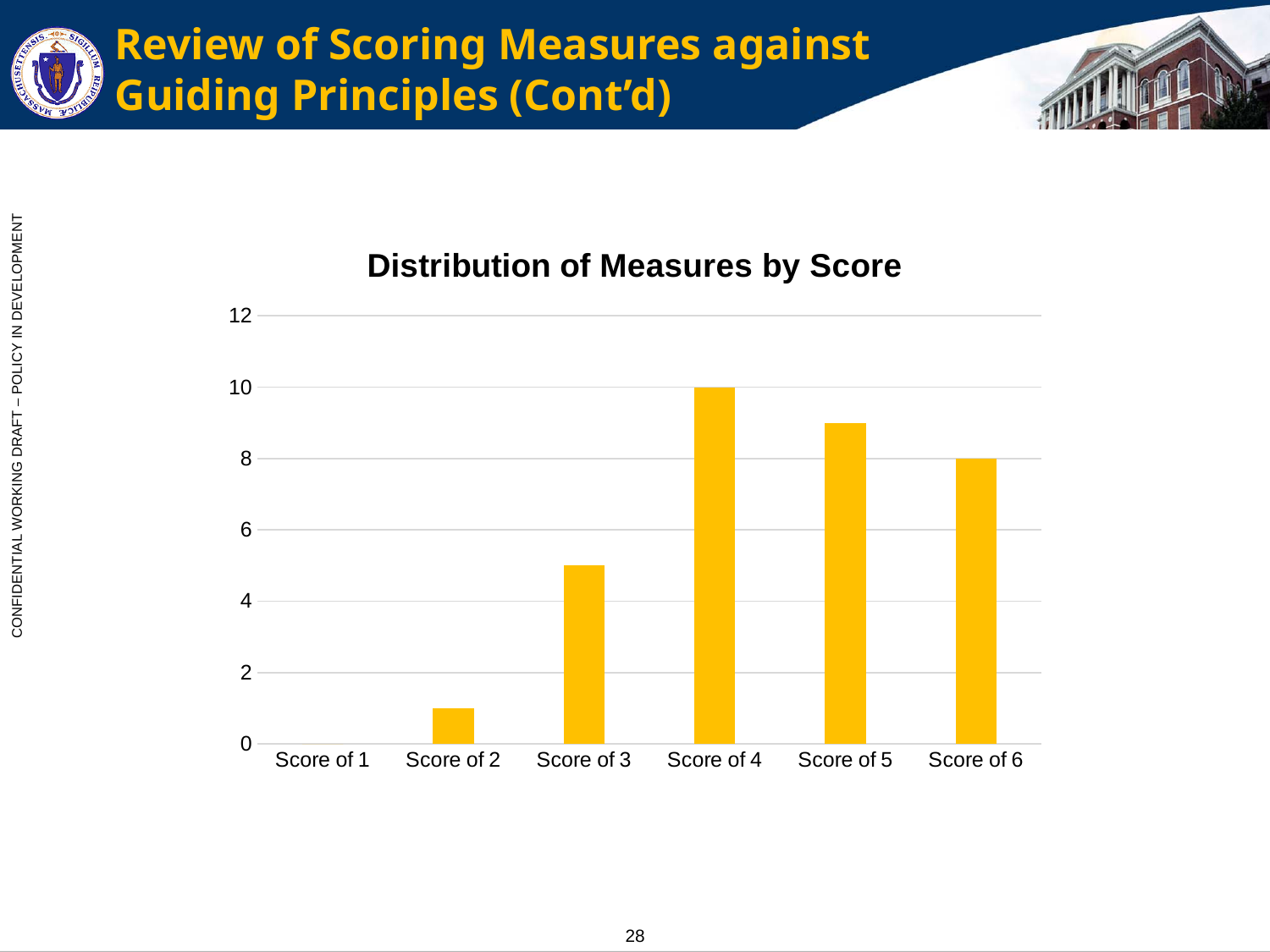
Is the value for Score of 3 greater or less than 4? greater What is the value for Score of 1? 0 Is the value for Score of 2 greater or less than 2? less What type of chart is shown on the slide? Bar chart Which score category has the highest number of measures? Score of 4 What is the difference between the values for Score of 4 and Score of 6? 2 Which score category has the lowest number of measures? Score of 1 How many score categories are shown on the x axis? 6 What is the value for Score of 6? 8 What is the value for Score of 4? 10 What is the title of the chart? Distribution of Measures by Score Which is larger, the value for Score of 5 or the value for Score of 3? Score of 5